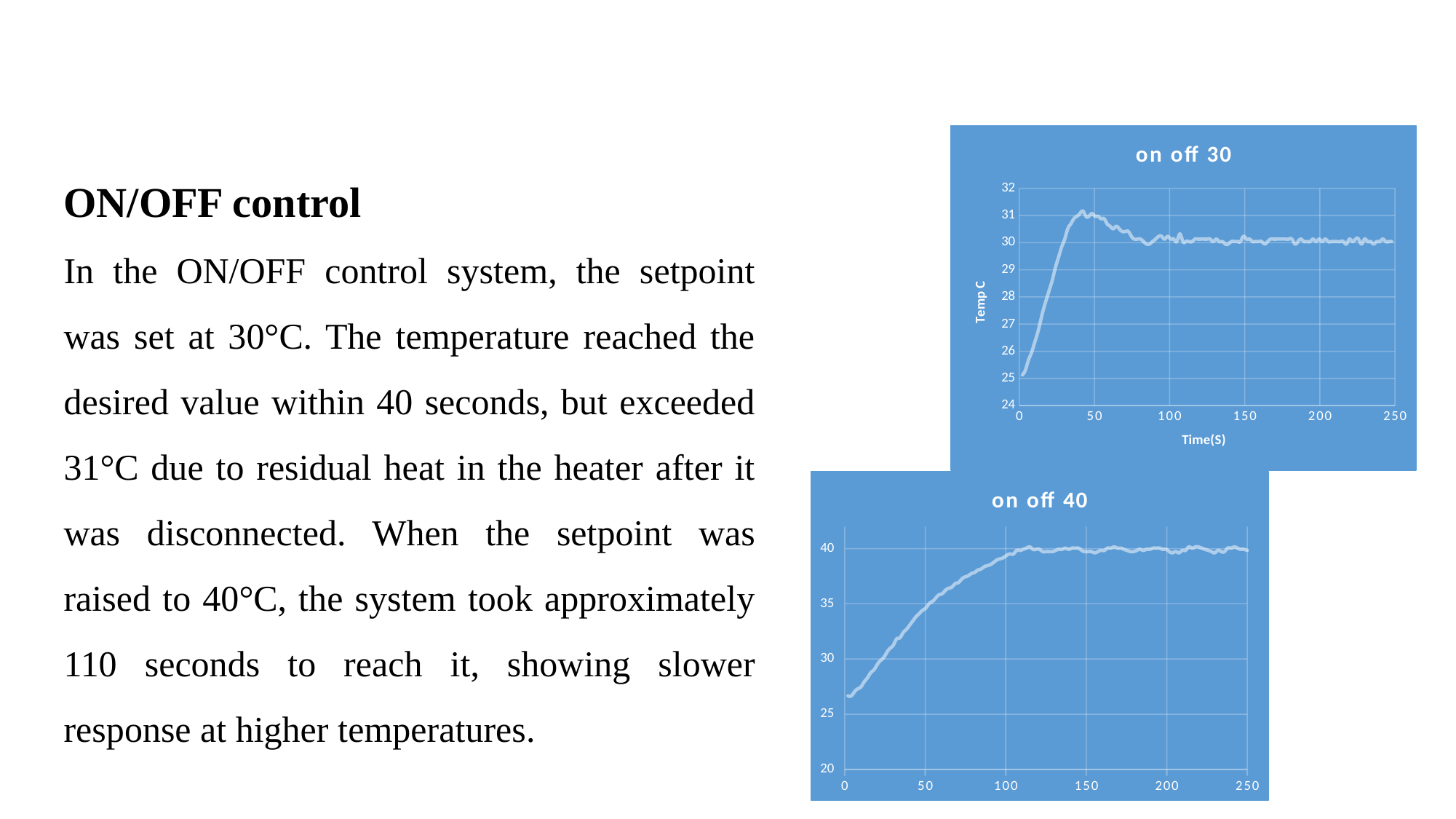
What kind of chart is the "on off 40" chart? line chart In the "on off 30" chart, is the temperature at time 200 greater or less than 29? greater In the "on off 30" chart, what is the label on the horizontal axis? Time(S) In the "on off 40" chart, is the temperature at time 200 greater or less than 35? greater In the "on off 30" chart, is the temperature at time 0 greater or less than 26? less What kind of chart is the "on off 30" chart? line chart In the "on off 30" chart, what is the label on the vertical axis? Temp C How many charts are shown on the slide? 2 In the "on off 30" chart, does the temperature rise or fall between time 0 and time 40? rise In the "on off 40" chart, what is the highest value shown on the horizontal axis? 250 In the "on off 40" chart, does the temperature rise or fall between time 0 and time 100? rise